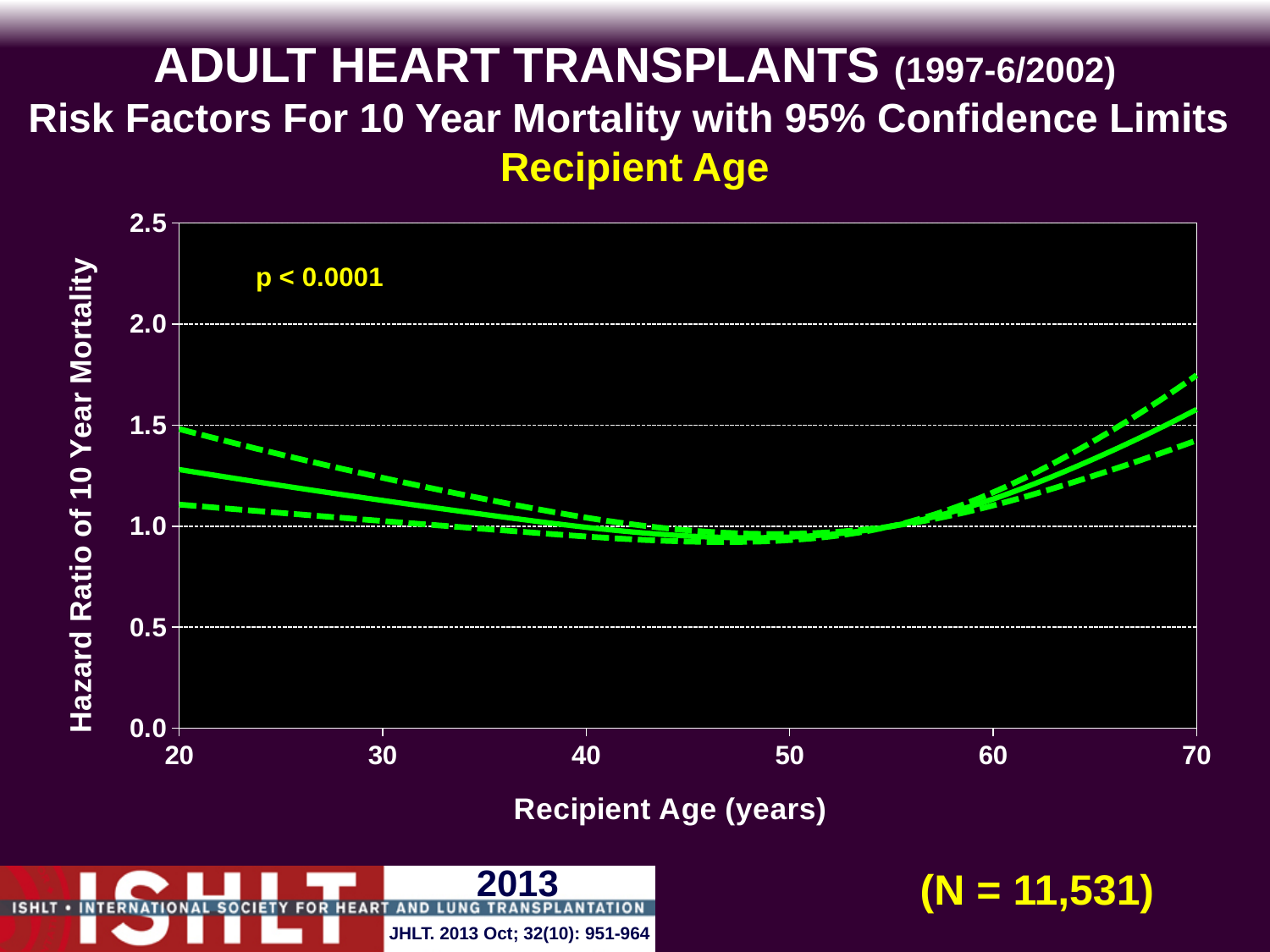
What is the label of the y axis? Hazard Ratio of 10 Year Mortality Is the hazard ratio of the upper dashed confidence limit at recipient age 70 greater or less than 1.5? greater Does the hazard ratio of the solid line rise or fall as recipient age increases from 20 to 45? fall What kind of chart is shown on the slide? line chart Is the hazard ratio of the solid line at recipient age 20 greater or less than 1.0? greater Which recipient age has the higher hazard ratio on the solid line, 20 or 70? 70 How many lines are plotted on the chart? 3 Is the hazard ratio of the solid line at recipient age 40 greater or less than 1.5? less Does the hazard ratio of the solid line rise or fall as recipient age increases from 55 to 70? rise What is the label of the x axis? Recipient Age (years)